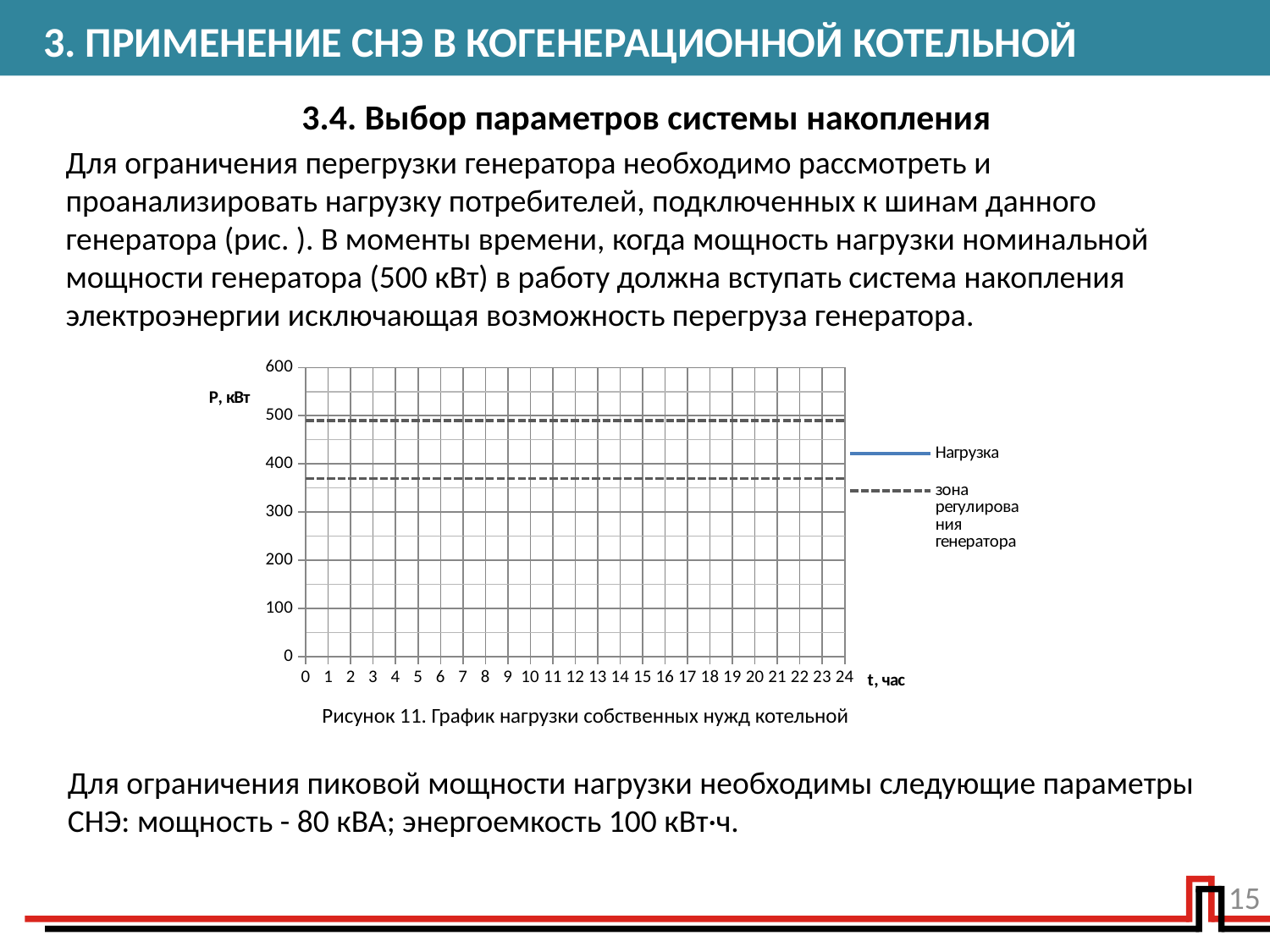
What is the second legend entry of the chart? зона регулирования генератора What is the highest value shown on the vertical axis of the chart? 600 Is the lower dashed line of the 'зона регулирования генератора' series greater or less than 300? greater Is the upper dashed line of the 'зона регулирования генератора' series greater or less than 400? greater What is the first legend entry of the chart? Нагрузка What kind of chart is shown in Figure 11 (Рисунок 11)? line chart Is the lower dashed line of the 'зона регулирования генератора' series greater or less than 400? less How many series does the chart legend list? 2 How many tick marks are labelled on the horizontal axis of the chart (from 0 to 24)? 25